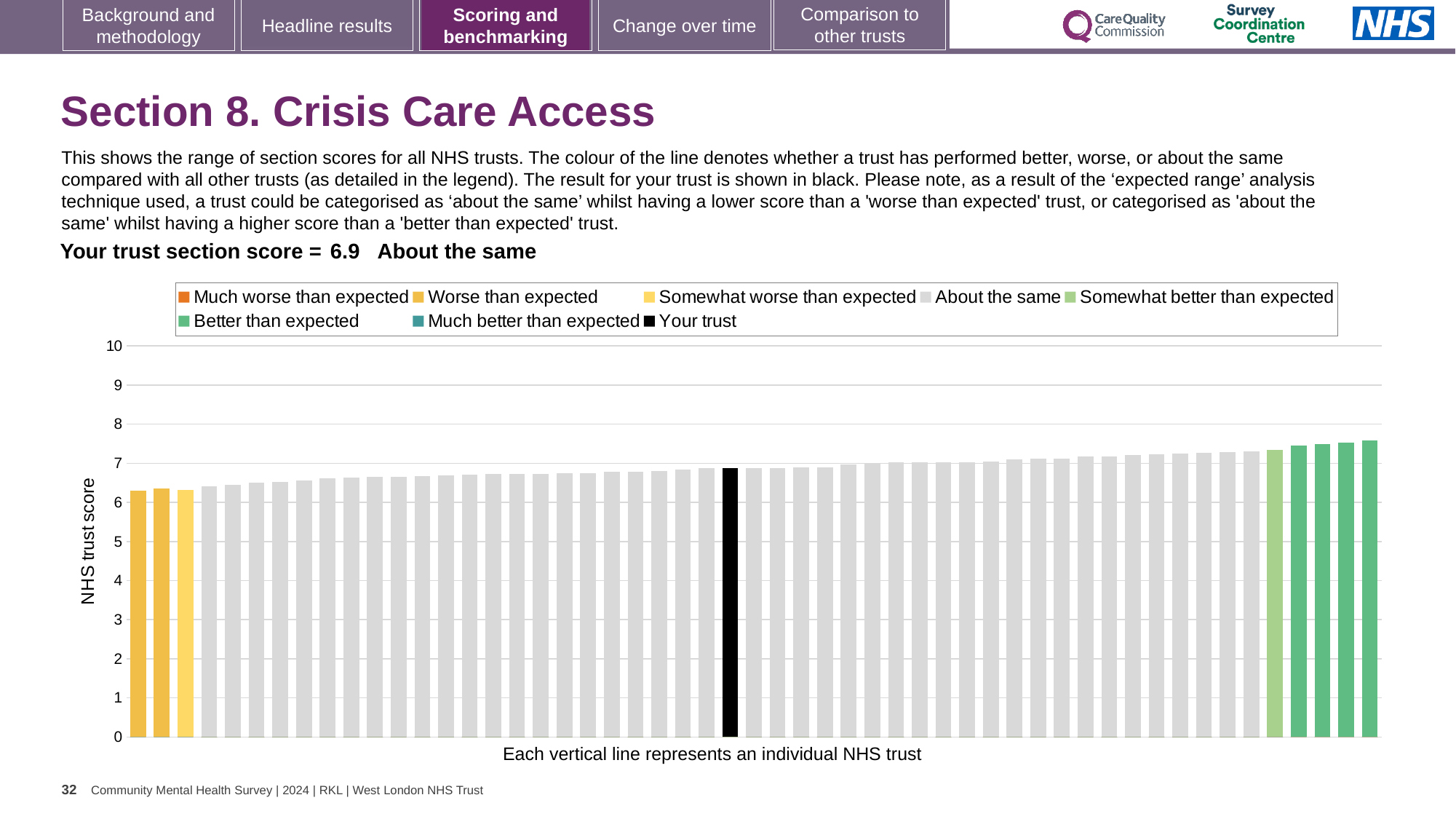
How many entries does the chart legend list? 8 How many bars are coloured yellow (worse than expected)? 3 What colour is the bar representing your trust? black What kind of chart is shown on the slide? bar chart Which performance category is your trust placed in for Section 8? About the same What is the section score for your trust shown on the slide? 6.9 Is the value of the highest bar greater or less than 8? less What is the highest value shown on the vertical axis? 10 Is the value of the lowest bar greater or less than 6? greater Is the value for your trust greater or less than 5? greater What is the label on the vertical axis of the chart? NHS trust score Do the bar values rise or fall from left to right across the chart? rise